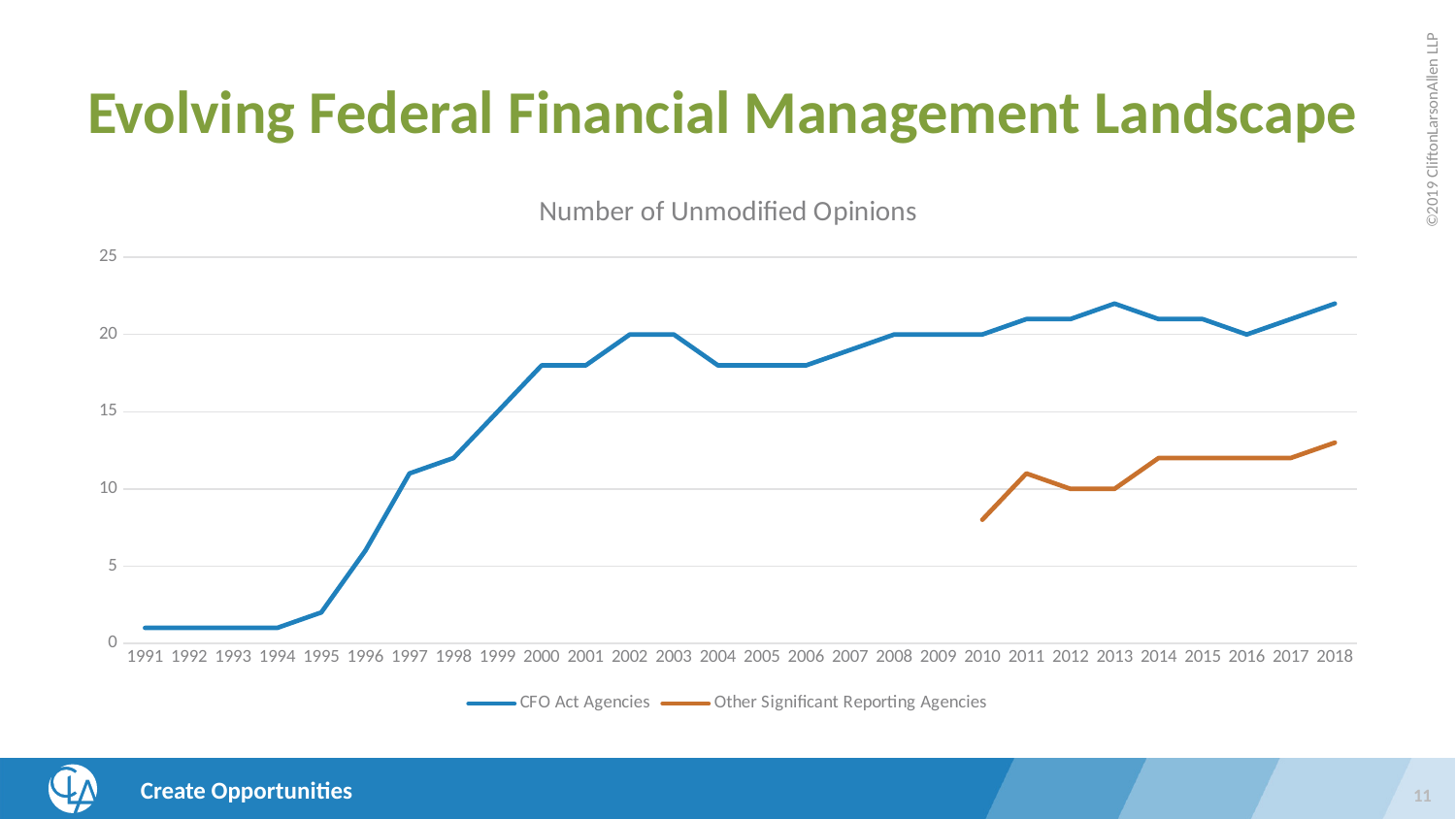
What is the value for Other Significant Reporting Agencies in 2012? 10 In 2018, which series has the larger value, CFO Act Agencies or Other Significant Reporting Agencies? CFO Act Agencies Is the value for CFO Act Agencies in 1997 greater or less than 10? greater What is the title of the chart? Number of Unmodified Opinions What is the value for CFO Act Agencies in 2016? 20 How many series does the legend list? 2 Is the value for Other Significant Reporting Agencies in 2010 greater or less than 10? less Does the CFO Act Agencies line generally rise or fall from 1991 to 2018? rise How many years are shown on the x axis? 28 In which year is the value for Other Significant Reporting Agencies lowest? 2010 What is the value for CFO Act Agencies in 2002? 20 What kind of chart is shown on the slide? line chart